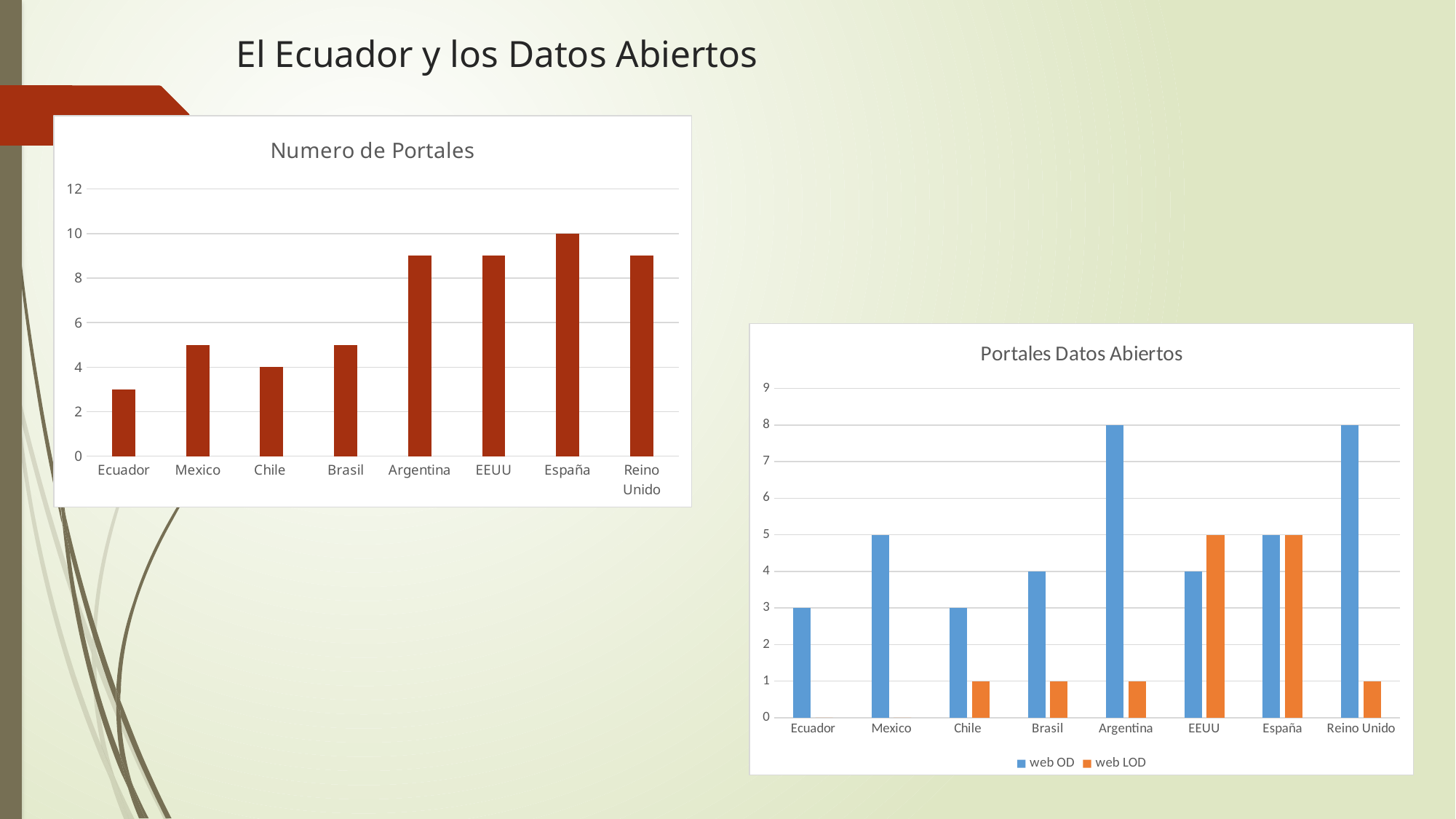
What kind of chart is the 'Portales Datos Abiertos' chart? bar chart In the 'Numero de Portales' chart, is the value for Argentina greater or less than 8? greater In the 'Portales Datos Abiertos' chart, what is the web OD value for Argentina? 8 In the 'Portales Datos Abiertos' chart, which is larger for EEUU, web OD or web LOD? web LOD In the 'Portales Datos Abiertos' chart, how many series does the legend list? 2 In the 'Numero de Portales' chart, what is the value for España? 10 In the 'Numero de Portales' chart, how many countries are shown on the x axis? 8 In the 'Numero de Portales' chart, which country has the lowest value? Ecuador In the 'Portales Datos Abiertos' chart, what is the difference between the web OD and web LOD values for Argentina? 7 In the 'Numero de Portales' chart, which country has the highest value? España In the 'Numero de Portales' chart, what is the value for Chile? 4 In the 'Portales Datos Abiertos' chart, what is the web LOD value for EEUU? 5